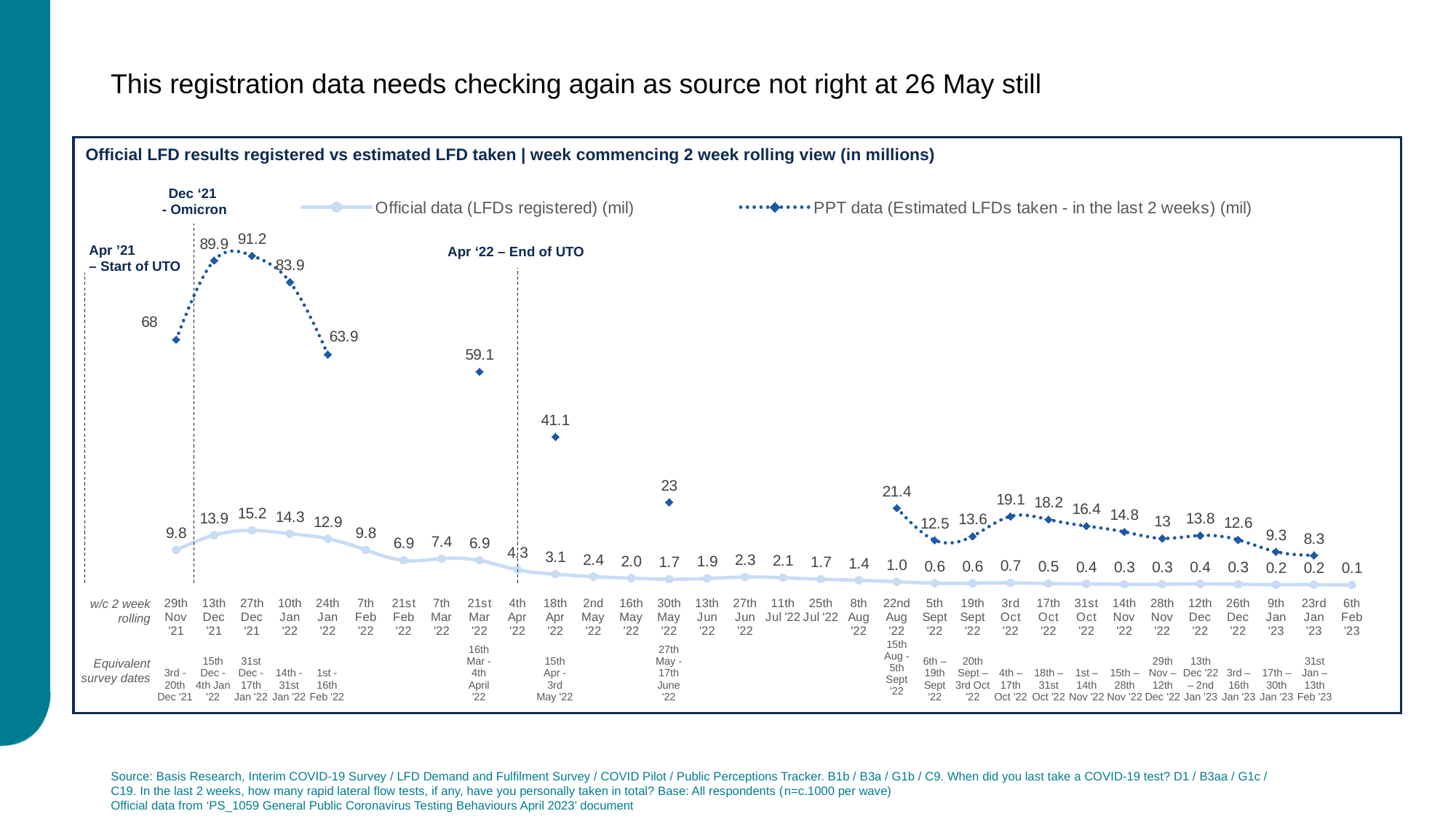
What is the PPT data (Estimated LFDs taken) value for the week commencing 18th Apr '22? 41.1 Which week has the highest PPT data (Estimated LFDs taken) value? 27th Dec '21 Which week has the highest Official data (LFDs registered) value? 27th Dec '21 Does the Official data (LFDs registered) series generally rise or fall from 27th Dec '21 to 6th Feb '23? Fall What is the difference between the Official data values for 13th Dec '21 and 24th Jan '22? 1.0 What kind of chart is this? Line chart What is the Official data value for the week commencing 6th Feb '23? 0.1 What is the difference between the PPT data value and the Official data value for the week commencing 29th Nov '21? 58.2 How many series does the legend list? 2 What is the Official data (LFDs registered) value for the week commencing 27th Dec '21? 15.2 How many weeks (categories) are shown on the x axis? 32 Which is larger: the PPT data value for 3rd Oct '22 or for 5th Sept '22? 3rd Oct '22